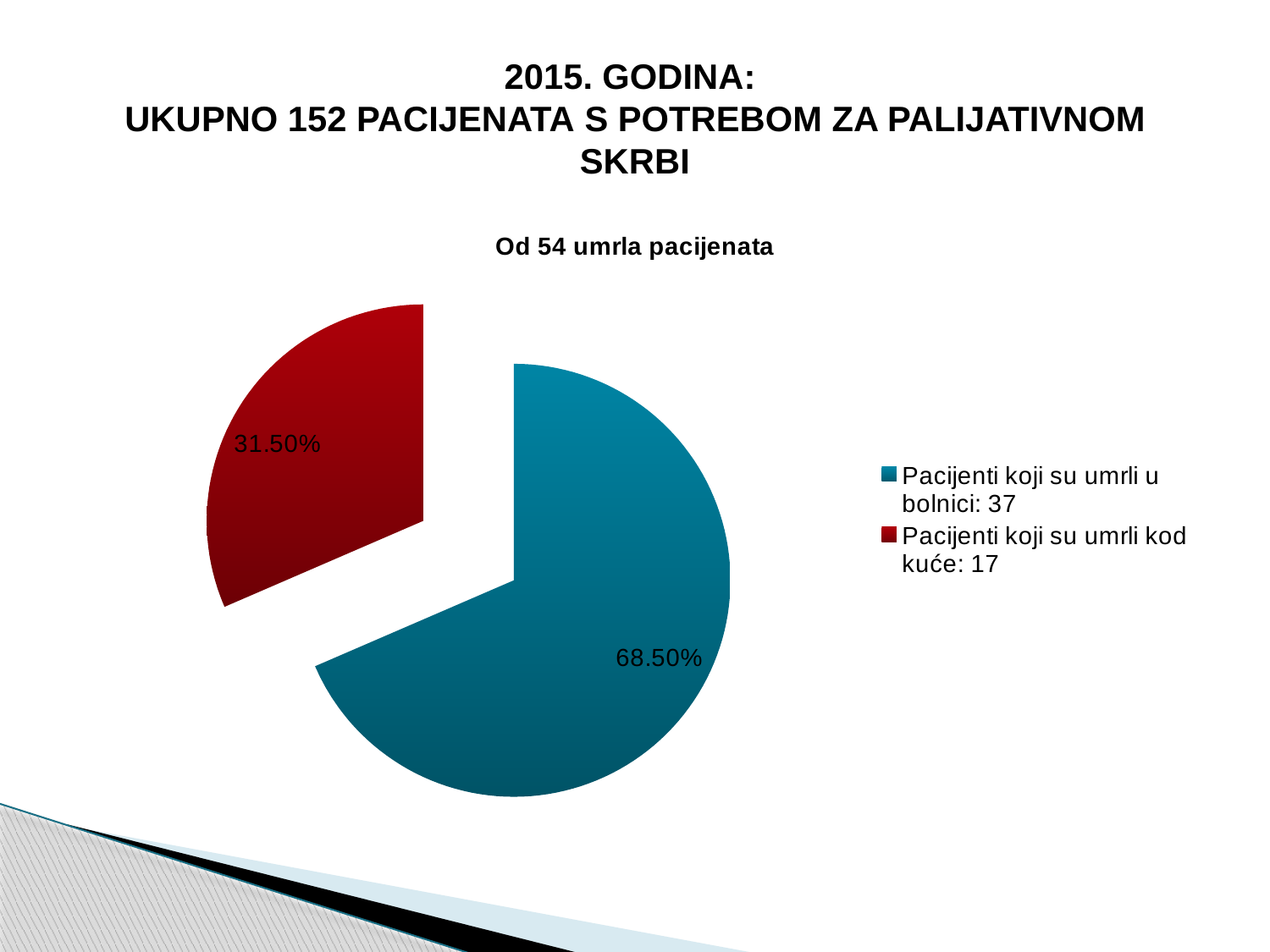
What is the difference in percentage points between the two slices? 37.00% What percentage share is shown for the slice 'Pacijenti koji su umrli u bolnici'? 68.50% Which slice is the smallest in the pie chart? Pacijenti koji su umrli kod kuće What kind of chart is shown on the slide? pie chart How many patients died in hospital ('Pacijenti koji su umrli u bolnici') according to the legend? 37 How many patients died at home ('Pacijenti koji su umrli kod kuće') according to the legend? 17 How many slices does the pie chart have? 2 What is the difference between the number of patients who died in hospital and those who died at home? 20 What percentage share is shown for the slice 'Pacijenti koji su umrli kod kuće'? 31.50% What is the title of the chart? Od 54 umrla pacijenata What colour is the slice for 'Pacijenti koji su umrli kod kuće'? red Which slice is the largest in the pie chart? Pacijenti koji su umrli u bolnici